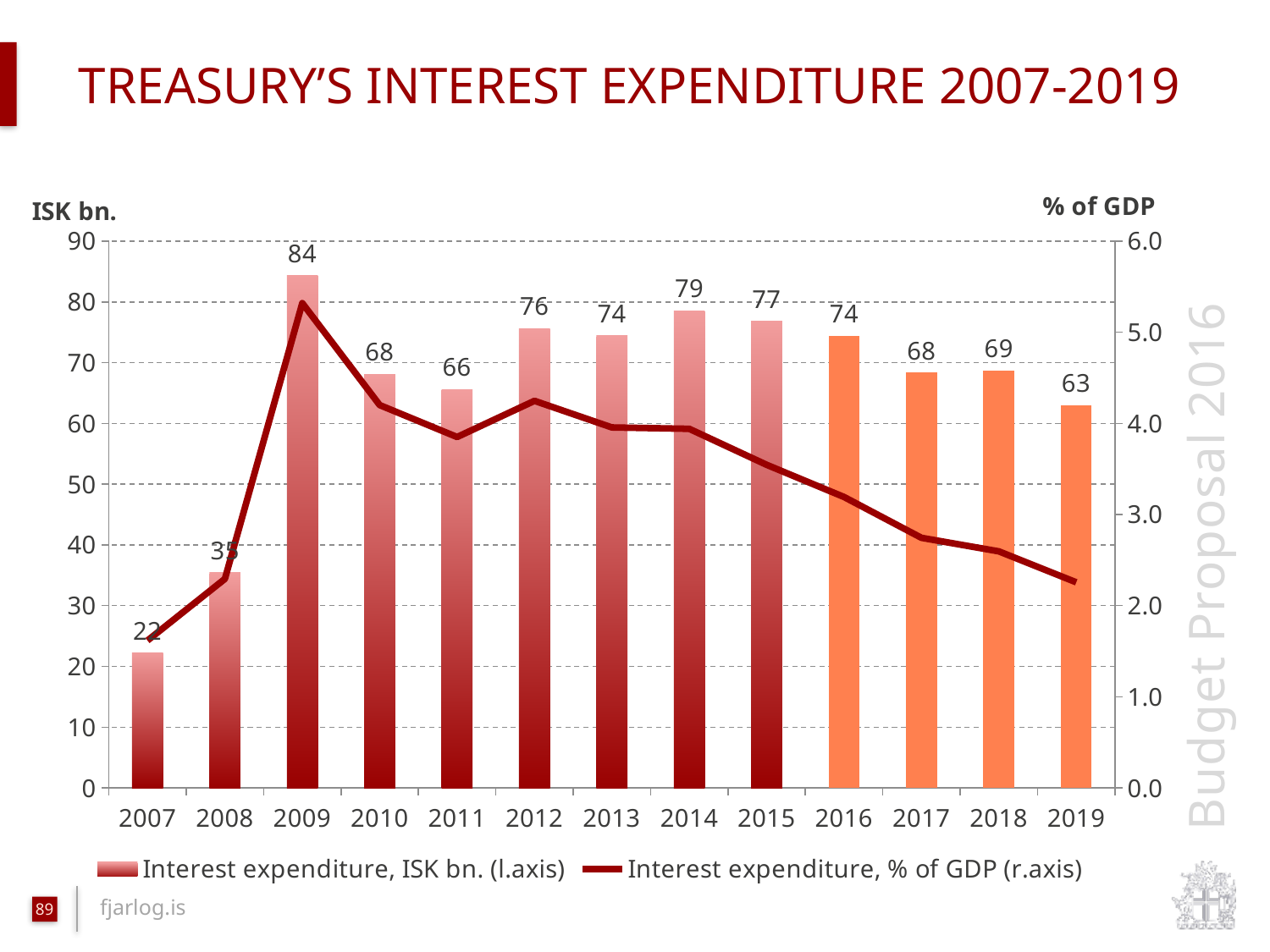
What is the interest expenditure in ISK bn. shown for 2007? 22 How many series does the legend list? 2 Does the interest expenditure as % of GDP rise or fall from 2015 to 2019? fall Which year has the lowest interest expenditure in ISK bn.? 2007 Is the interest expenditure as % of GDP for 2009 greater or less than 5.0? greater What is the interest expenditure in ISK bn. shown for 2019? 63 Is the interest expenditure as % of GDP for 2019 greater or less than 3.0? less Which year has the highest interest expenditure in ISK bn.? 2009 What is the difference in interest expenditure (ISK bn.) between 2009 and 2008? 49 What is the Treasury's interest expenditure in ISK bn. for 2009? 84 How many years are shown on the x axis of the chart? 13 Which year has the larger interest expenditure in ISK bn., 2014 or 2015? 2014